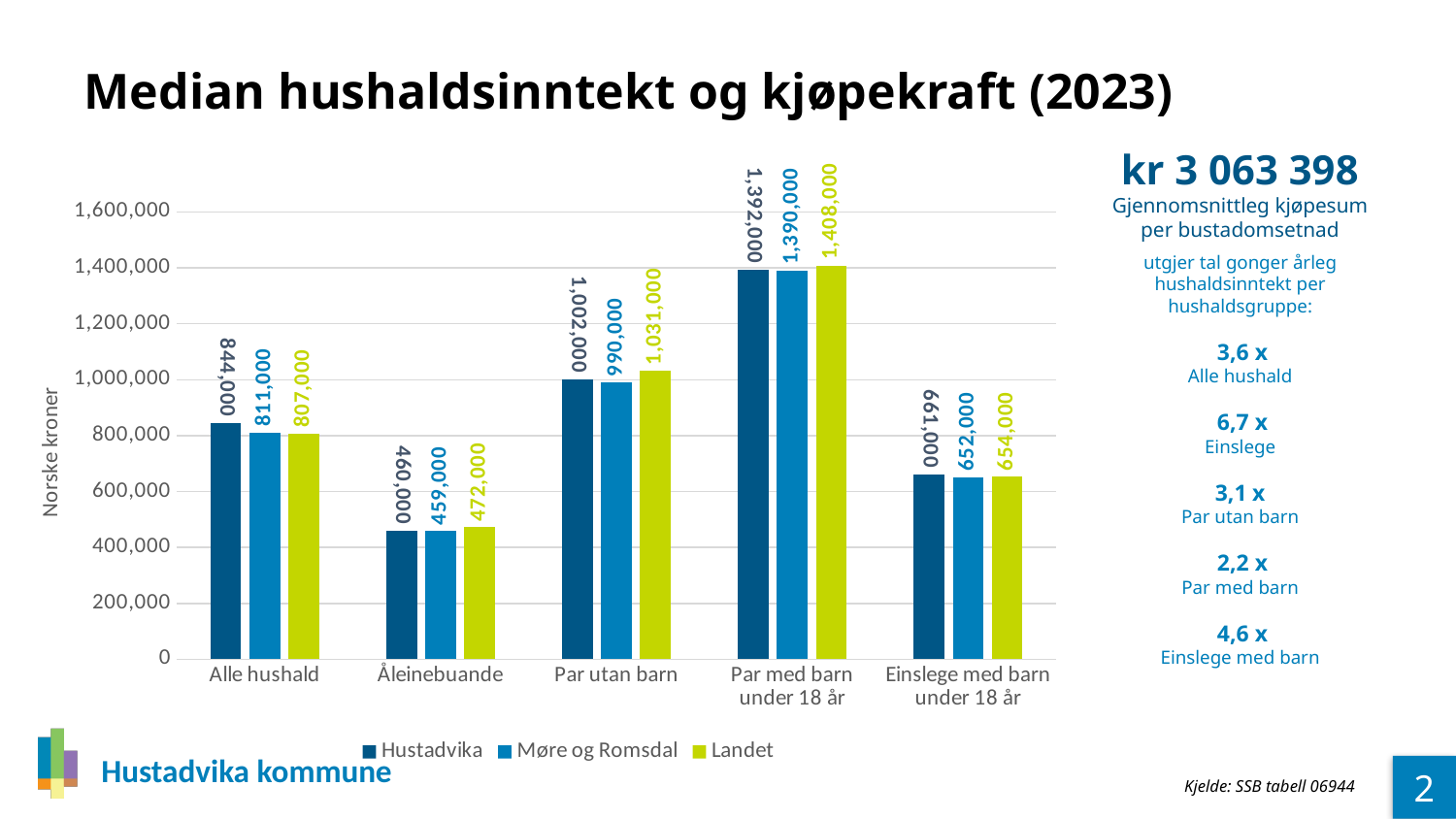
What kind of chart is shown on the slide? bar chart What is the value for Møre og Romsdal in the Einslege med barn under 18 år category? 652,000 How many series does the legend list? 3 Is the value for Møre og Romsdal in the Par utan barn category greater or less than 1,000,000? less What is the difference between the Landet and Hustadvika values in the Alle hushald category? 37,000 What is the value for Hustadvika in the Alle hushald category? 844,000 How many household categories are shown on the x axis? 5 What is the label of the y axis? Norske kroner Which category has the lowest value for the Hustadvika series? Åleinebuande What is the value for Landet in the Par utan barn category? 1,031,000 Which category has the highest value for the Landet series? Par med barn under 18 år Which is larger in the Åleinebuande category: the value for Hustadvika or the value for Landet? Landet